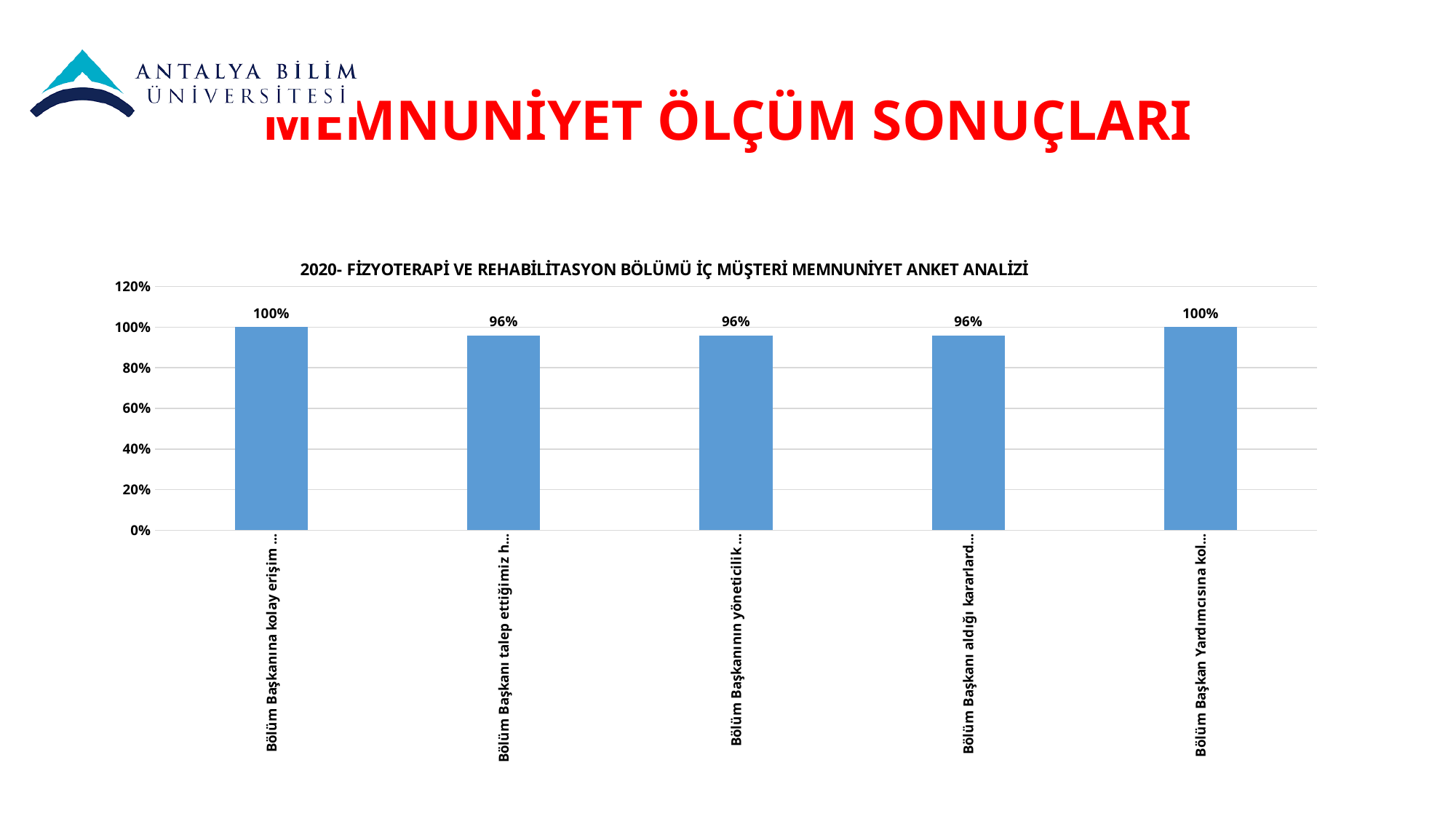
What is the value of the bar labelled "Bölüm Başkanı talep ettiğimiz h..."? 96% What is the value of the bar labelled "Bölüm Başkanının yöneticilik ..."? 96% How many bars in the chart have a value of 100%? 2 What is the value of the last bar, labelled "Bölüm Başkan Yardımcısına kol..."? 100% What is the difference between the value for "Bölüm Başkan Yardımcısına kol..." and the value for "Bölüm Başkanı aldığı kararlard..."? 4% Which is larger: the value for "Bölüm Başkanına kolay erişim ..." or the value for "Bölüm Başkanı talep ettiğimiz h..."? Bölüm Başkanına kolay erişim ... What is the title of the chart? 2020- FİZYOTERAPİ VE REHABİLİTASYON BÖLÜMÜ İÇ MÜŞTERİ MEMNUNİYET ANKET ANALİZİ What type of chart is shown on the slide? Bar chart What is the highest value shown on the vertical axis? 120% What is the value of the bar labelled "Bölüm Başkanı aldığı kararlard..."? 96% How many bars are plotted in the chart? 5 What is the value of the first bar, labelled "Bölüm Başkanına kolay erişim ..."? 100%